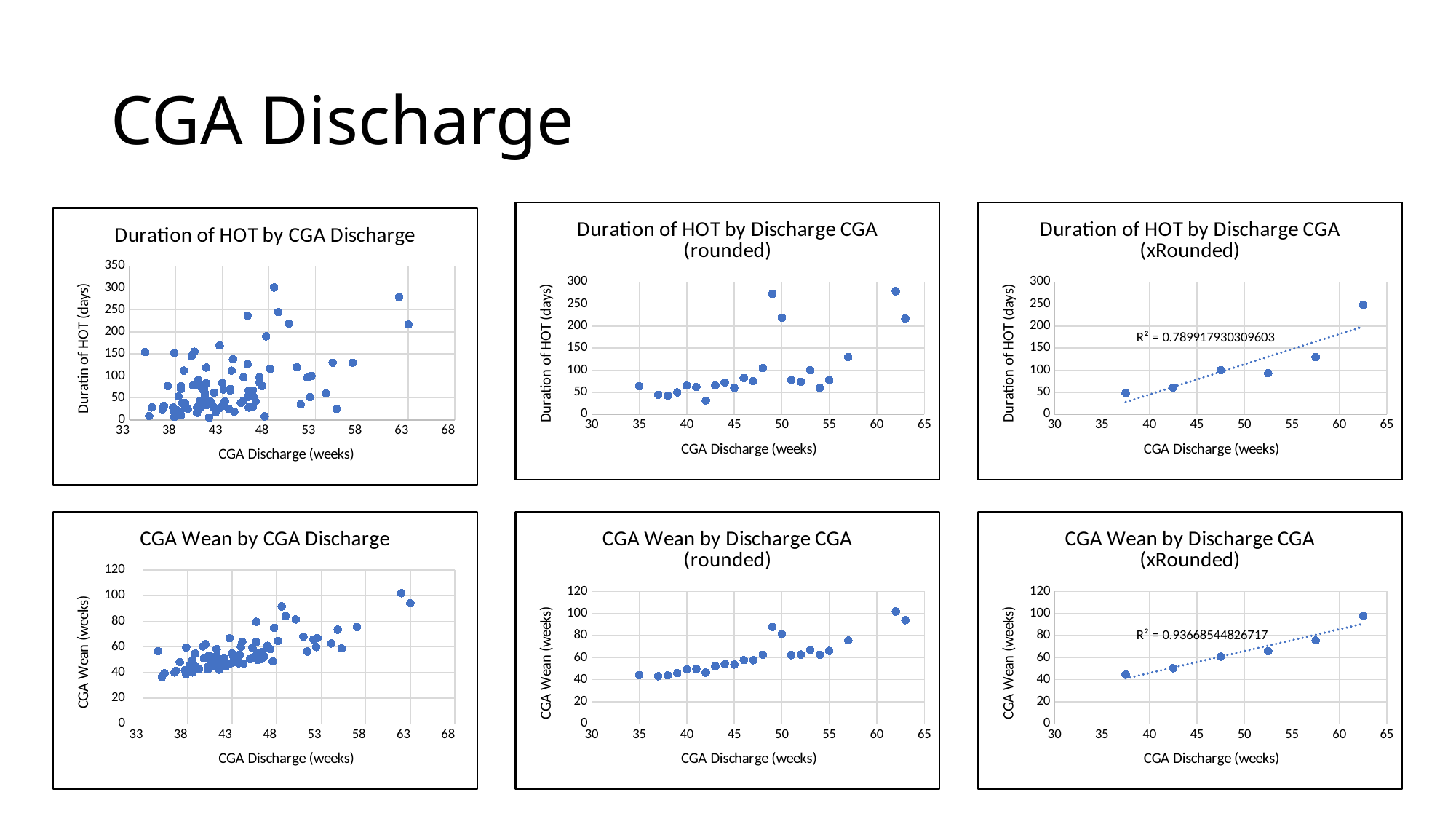
In the chart "CGA Wean by Discharge CGA (xRounded)", what R² value is printed? R² = 0.93668544826717 In the chart "Duration of HOT by Discharge CGA (xRounded)", is the value for the leftmost point (at about 37.5 weeks) greater or less than 100? less What kind of chart is "Duration of HOT by CGA Discharge"? Scatter chart What is the x-axis title of the chart "CGA Wean by CGA Discharge"? CGA Discharge (weeks) In the chart "Duration of HOT by CGA Discharge", is the highest plotted value greater or less than 250? greater How many data points are plotted in the chart "Duration of HOT by Discharge CGA (xRounded)"? 6 In the chart "CGA Wean by Discharge CGA (xRounded)", is the value for the rightmost point (at about 62.5 weeks) greater or less than 80? greater How many data points are plotted in the chart "CGA Wean by Discharge CGA (xRounded)"? 6 In the chart "Duration of HOT by Discharge CGA (xRounded)", what R² value is printed? R² = 0.789917930309603 Which chart shows the higher R² value, "Duration of HOT by Discharge CGA (xRounded)" or "CGA Wean by Discharge CGA (xRounded)"? CGA Wean by Discharge CGA (xRounded) In the chart "CGA Wean by Discharge CGA (xRounded)", do the values rise or fall as CGA Discharge increases? Rise